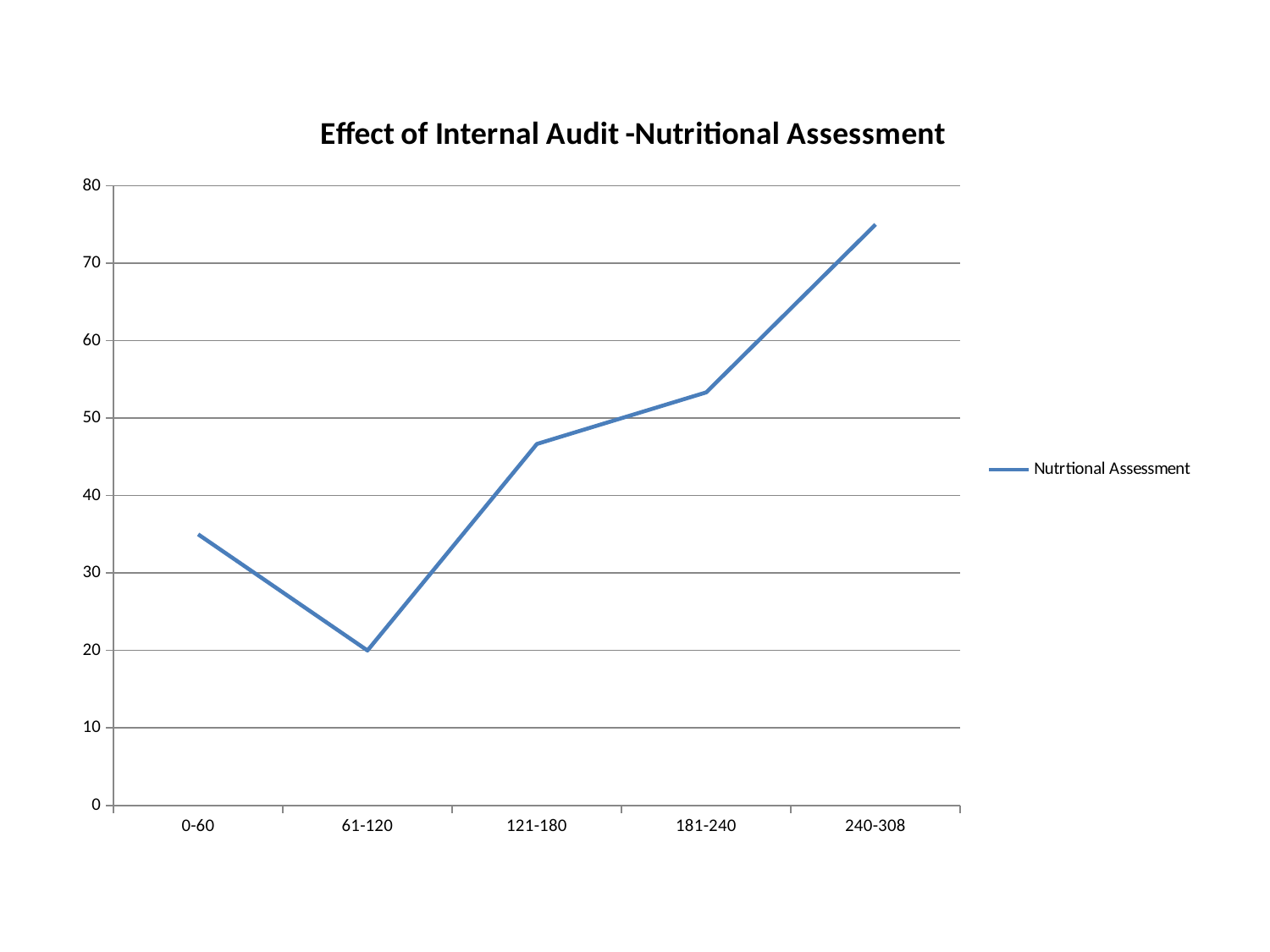
Which category has the highest value? 240-308 Does the line rise or fall from 61-120 to 240-308? rise Is the value for 121-180 greater or less than 50? less Which category has the lowest value? 61-120 Is the value for 240-308 greater or less than 70? greater Which is larger, the value for 181-240 or the value for 0-60? 181-240 What kind of chart is shown on the slide? line chart What is the title of the chart? Effect of Internal Audit -Nutritional Assessment Is the value for 0-60 greater or less than 30? greater How many categories are shown on the x axis? 5 What is the value for 61-120? 20 How many series does the legend list? 1